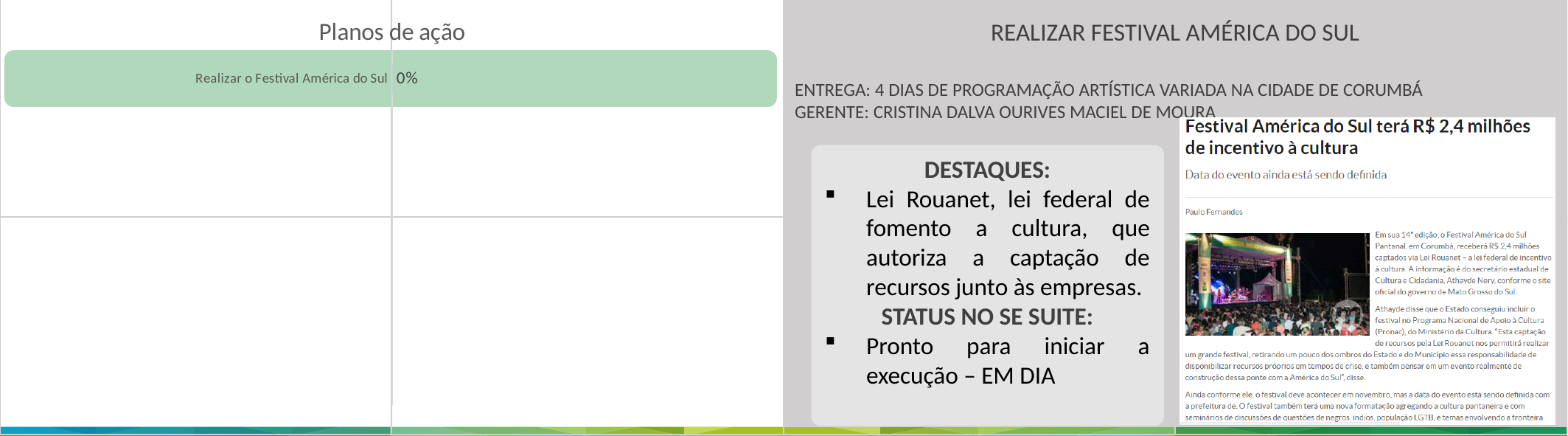
In the 'Planos de ação' chart, what is the value shown for 'Realizar o Festival América do Sul'? 0% What is the title of the chart on the left side of the slide? Planos de ação What is the label of the only category in the 'Planos de ação' chart? Realizar o Festival América do Sul How many categories are plotted in the 'Planos de ação' chart? 1 What kind of chart is the 'Planos de ação' chart? Bar chart